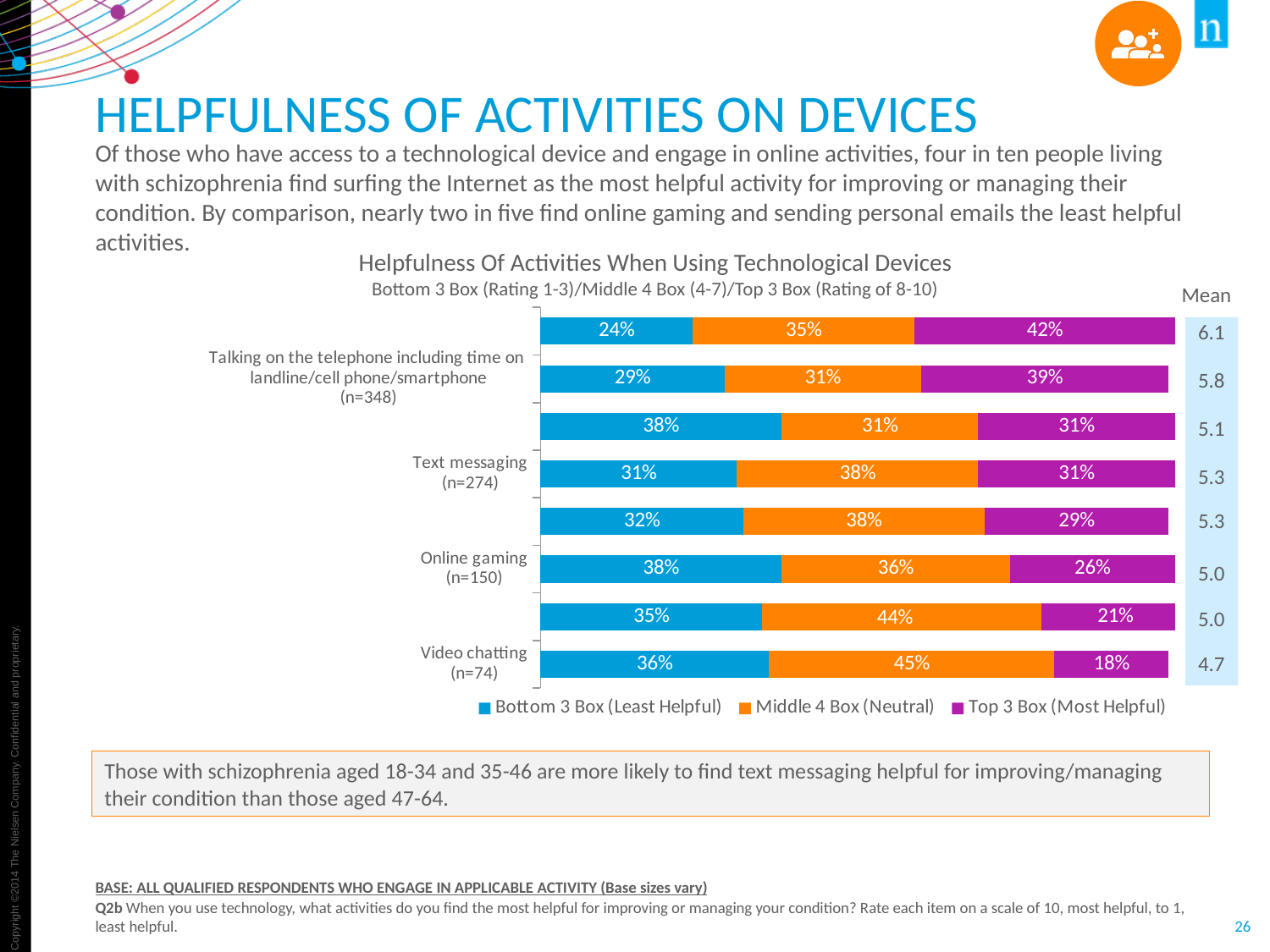
What is the highest Mean value shown in the chart? 6.1 What is the Bottom 3 Box (Least Helpful) percentage for Online gaming (n=150)? 38% How many series does the chart legend list? 3 What is the Top 3 Box (Most Helpful) percentage for Video chatting (n=74)? 18% Which is larger for Online gaming (n=150): the Bottom 3 Box percentage or the Top 3 Box percentage? Bottom 3 Box (38%) Which labeled activity has the lowest Top 3 Box (Most Helpful) percentage? Video chatting (n=74) What is the difference between the Top 3 Box percentages for Talking on the telephone (n=348) and Video chatting (n=74)? 21% How many bars are plotted in the chart? 8 What kind of chart is shown on the slide? Stacked bar chart What is the Mean value shown for Talking on the telephone including time on landline/cell phone/smartphone (n=348)? 5.8 What is the Mean value shown for Video chatting (n=74)? 4.7 What is the Middle 4 Box (Neutral) percentage for Text messaging (n=274)? 38%